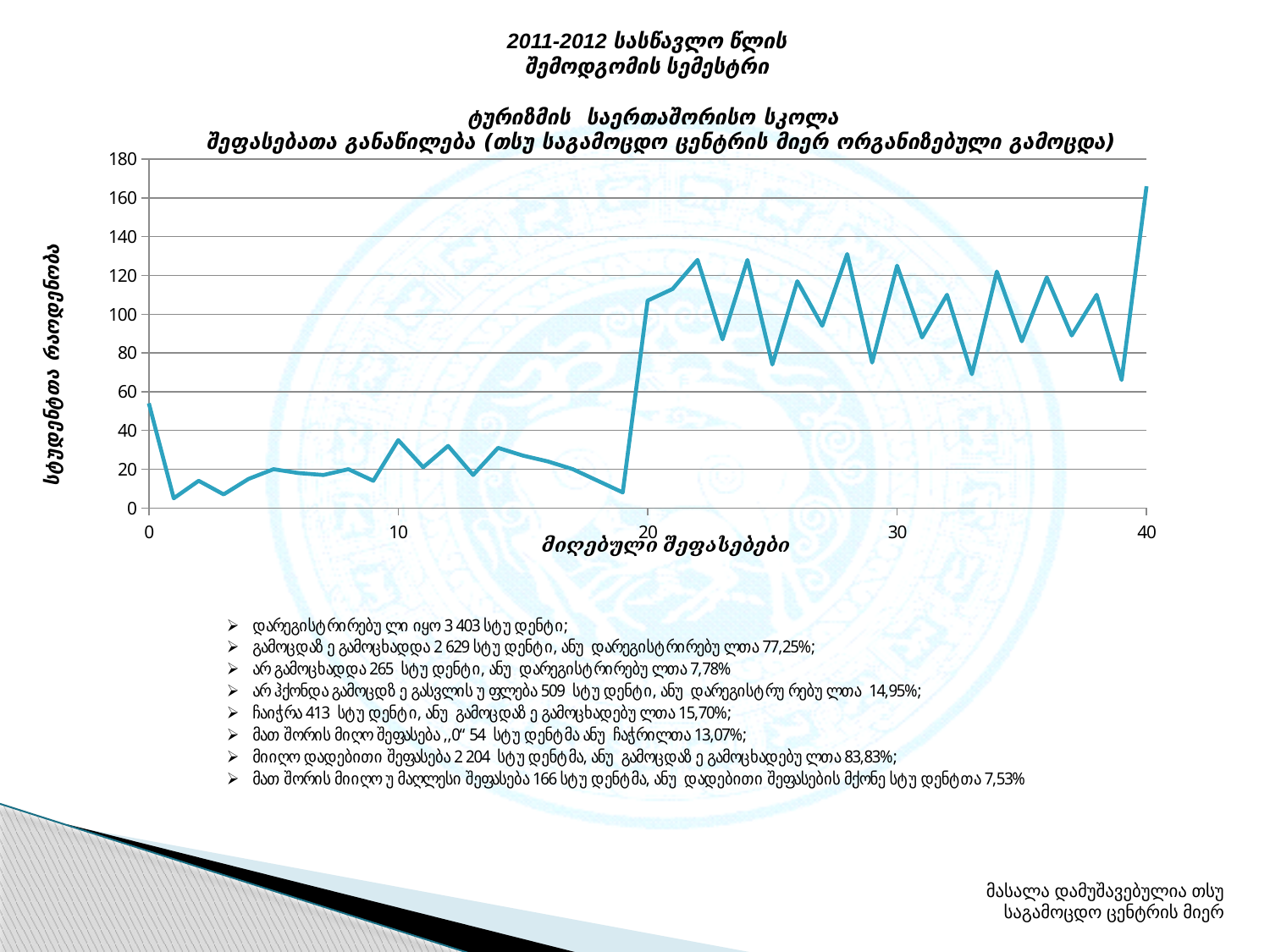
Does the line rise or fall between score 39 and score 40? rises Which has more students: score 20 or score 19? score 20 What is the label of the y axis? სტუდენტთა რაოდენობა What kind of chart is shown on the slide? line chart Is the number of students for score 10 greater or less than 20? greater Is the number of students for score 20 greater or less than 100? greater Is the number of students for score 39 greater or less than 80? less What is the label of the x axis? მიღებული შეფასებები At which score on the x axis does the line reach its highest value? 40